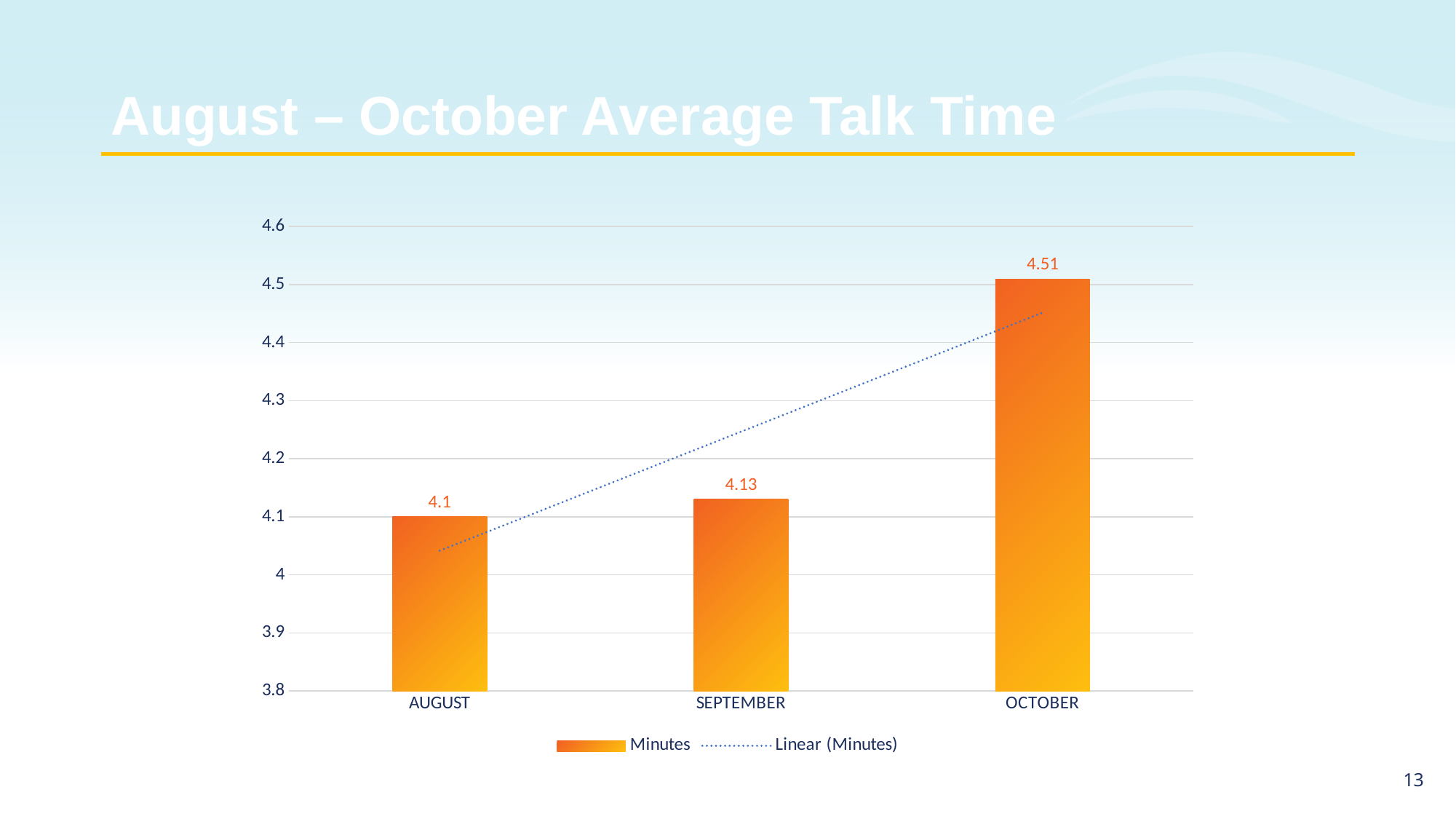
Which month has the highest average talk time? OCTOBER What is the value for SEPTEMBER? 4.13 What kind of chart is shown on the slide? bar chart What is the difference between the values for OCTOBER and SEPTEMBER? 0.38 Which is larger, the value for OCTOBER or the value for SEPTEMBER? OCTOBER Is the value for OCTOBER greater or less than 4.4? greater Which month has the lowest average talk time? AUGUST How many months are shown on the x axis? 3 What is the value for AUGUST? 4.1 How many entries does the legend list? 2 What is the value for OCTOBER? 4.51 What is the difference between the values for OCTOBER and AUGUST? 0.41